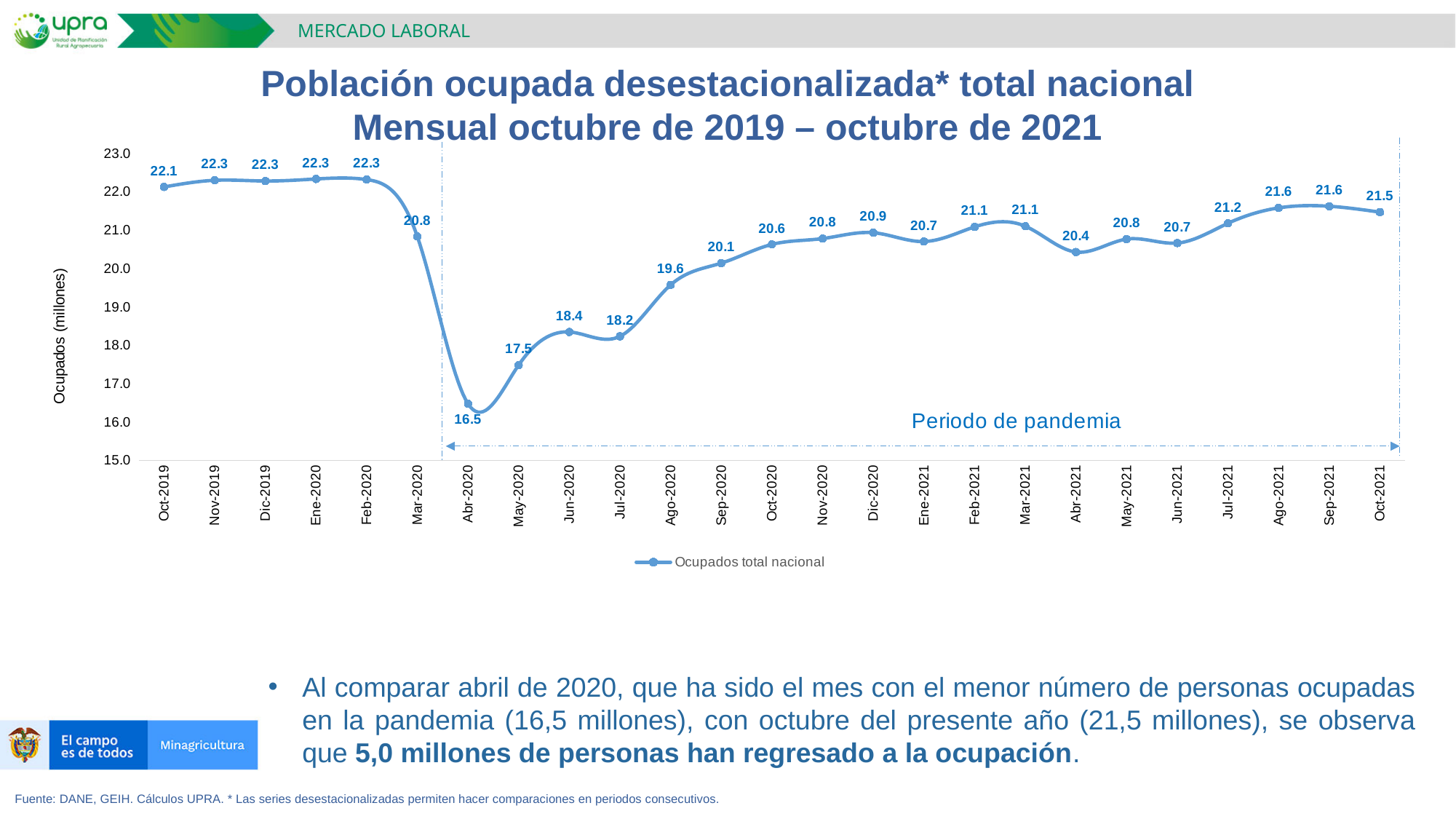
How many monthly data points are plotted? 25 What kind of chart is shown? line chart Do the values rise or fall from Abr-2020 to Jun-2020? rise What is the value for Oct-2021? 21.5 What is the value for Mar-2020? 20.8 Which is larger, the value for Jun-2020 or the value for Jul-2020? Jun-2020 What is the value for Abr-2020? 16.5 Is the value for Ago-2020 greater or less than 20.0? less How many series does the legend list? 1 What is the difference between the values for Oct-2021 and Abr-2020? 5.0 What is the difference between the values for Mar-2020 and Abr-2020? 4.3 Which month has the lowest value? Abr-2020